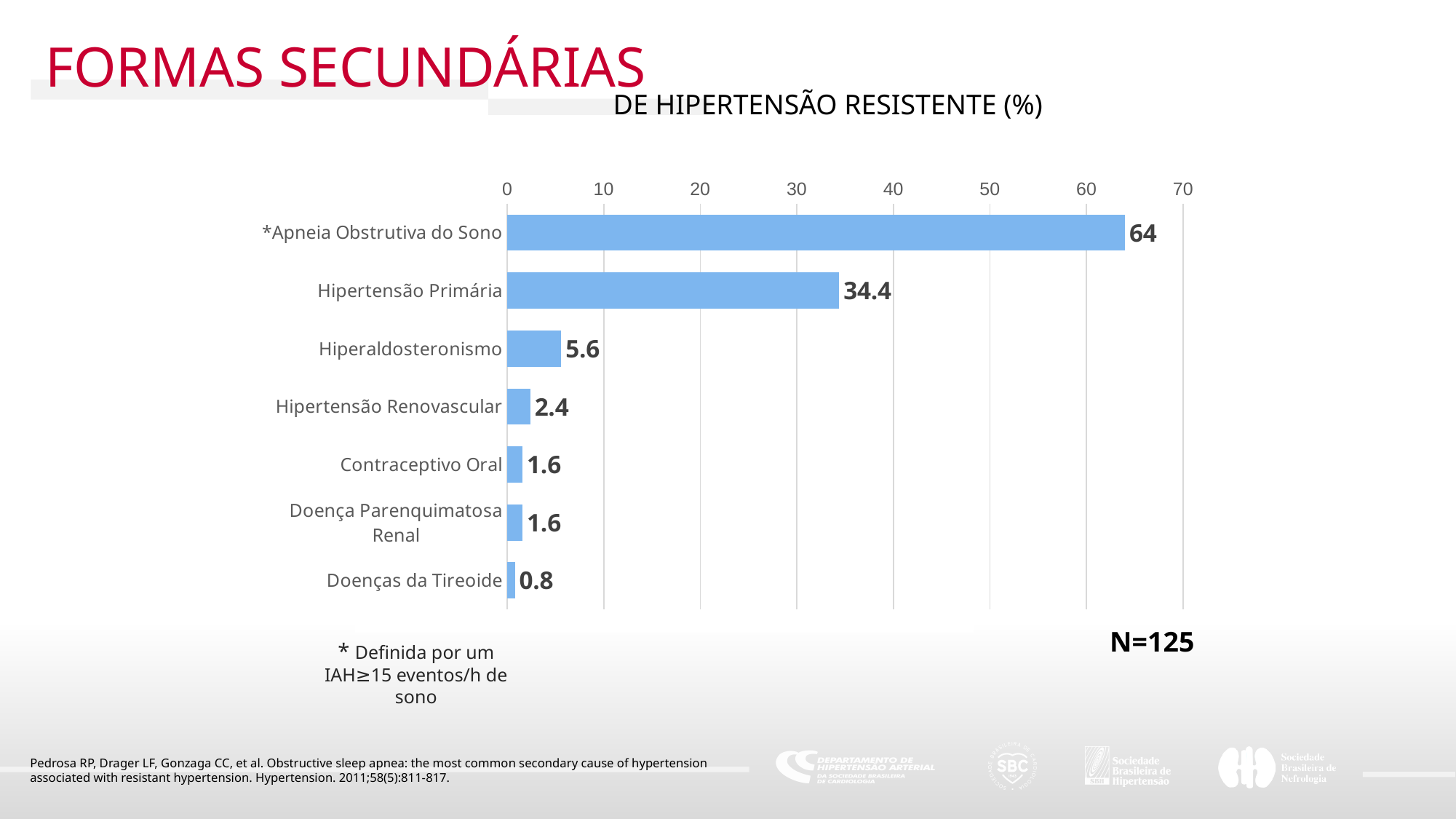
Which is larger, the value for Hiperaldosteronismo or the value for Hipertensão Renovascular? Hiperaldosteronismo Which category has the highest value? *Apneia Obstrutiva do Sono How many categories are shown in the chart? 7 What is the value for Hipertensão Primária? 34.4 What kind of chart is shown on the slide? Bar chart What is the difference between the values for *Apneia Obstrutiva do Sono and Hipertensão Primária? 29.6 Which category has the lowest value? Doenças da Tireoide What sample size (N) is shown on the slide? N=125 What is the value for Doenças da Tireoide? 0.8 What is the value for Hipertensão Renovascular? 2.4 What is the value for *Apneia Obstrutiva do Sono? 64 What is the value for Hiperaldosteronismo? 5.6